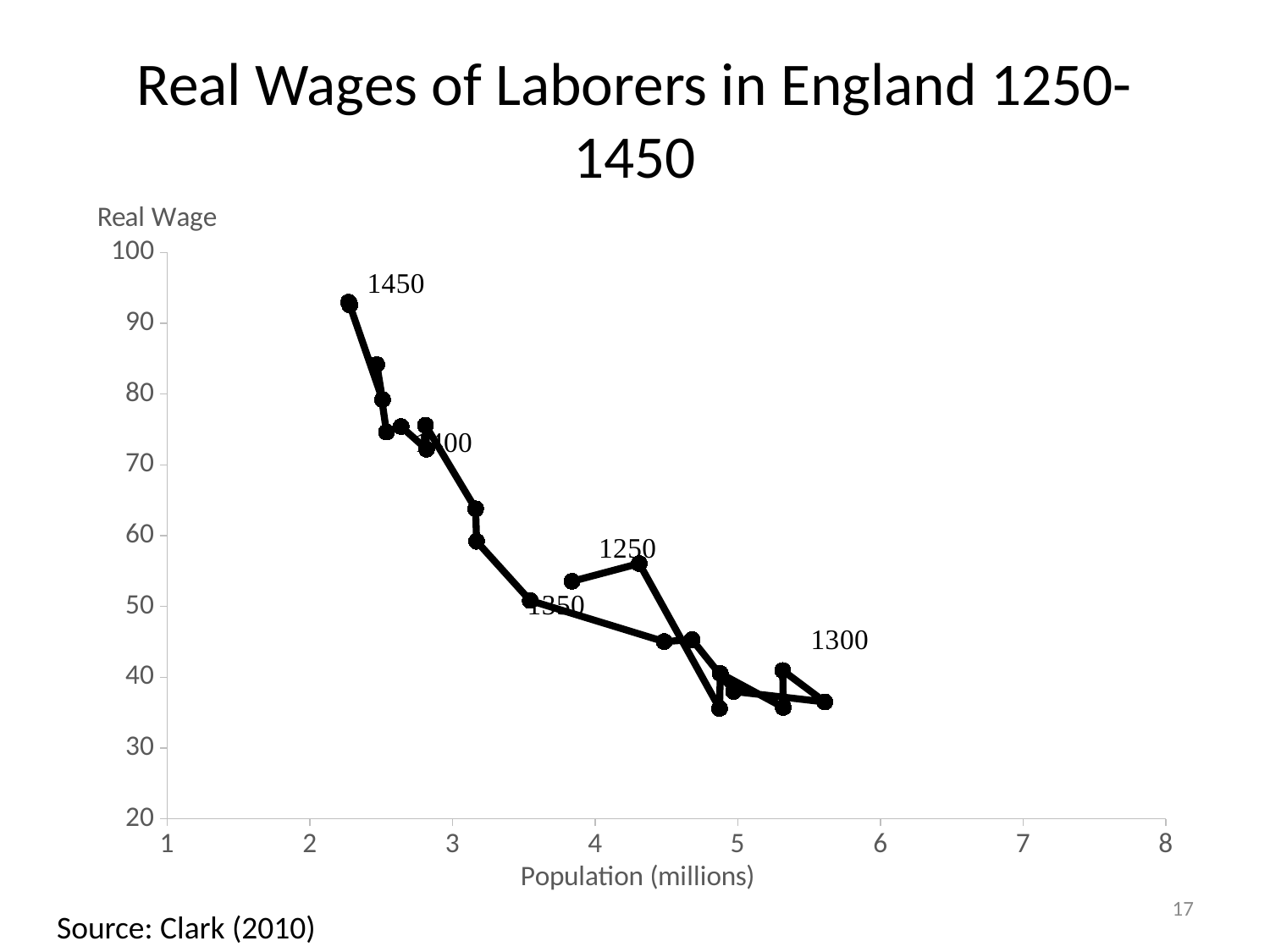
What is the label of the horizontal axis? Population (millions) As population increases along the x axis, does the real wage generally rise or fall? fall Is the population at the point labeled 1450 greater or less than 3 million? less Is the population at the point labeled 1250 greater or less than 4 million? greater Is the real wage at the point labeled 1450 greater or less than 90? greater Which labeled year has the highest real wage? 1450 What kind of chart is shown on the slide? scatter chart with connected points (line chart) Which has the higher real wage, the point labeled 1450 or the point labeled 1250? 1450 What is the title of the chart? Real Wages of Laborers in England 1250-1450